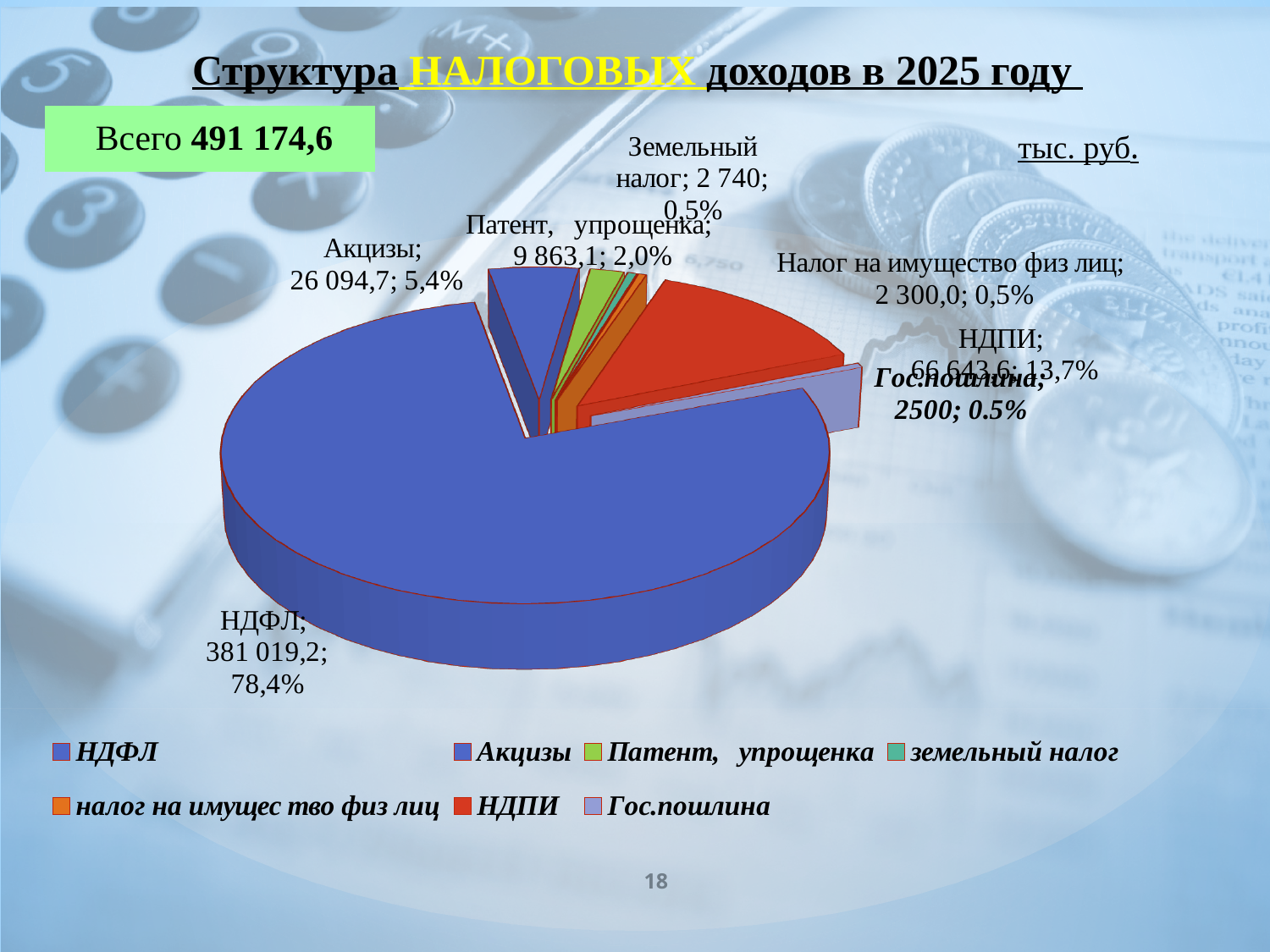
What is the value for Налог на имущество физ лиц in the pie chart? 2 300,0 How many categories does the legend of the pie chart list? 7 What is the value for Акцизы in the pie chart? 26 094,7 Which is larger in the pie chart, Акцизы or Патент, упрощенка? Акцизы What share of the pie does НДФЛ account for? 78,4% What is the difference between the values for Акцизы and Патент, упрощенка? 16 231,6 What is the value for Земельный налог in the pie chart? 2 740 What share of the pie does Акцизы account for? 5,4% What is the value for Патент, упрощенка in the pie chart? 9 863,1 What is the value for НДФЛ in the pie chart? 381 019,2 What kind of chart is shown on the slide? pie chart Which category has the largest slice in the pie chart? НДФЛ